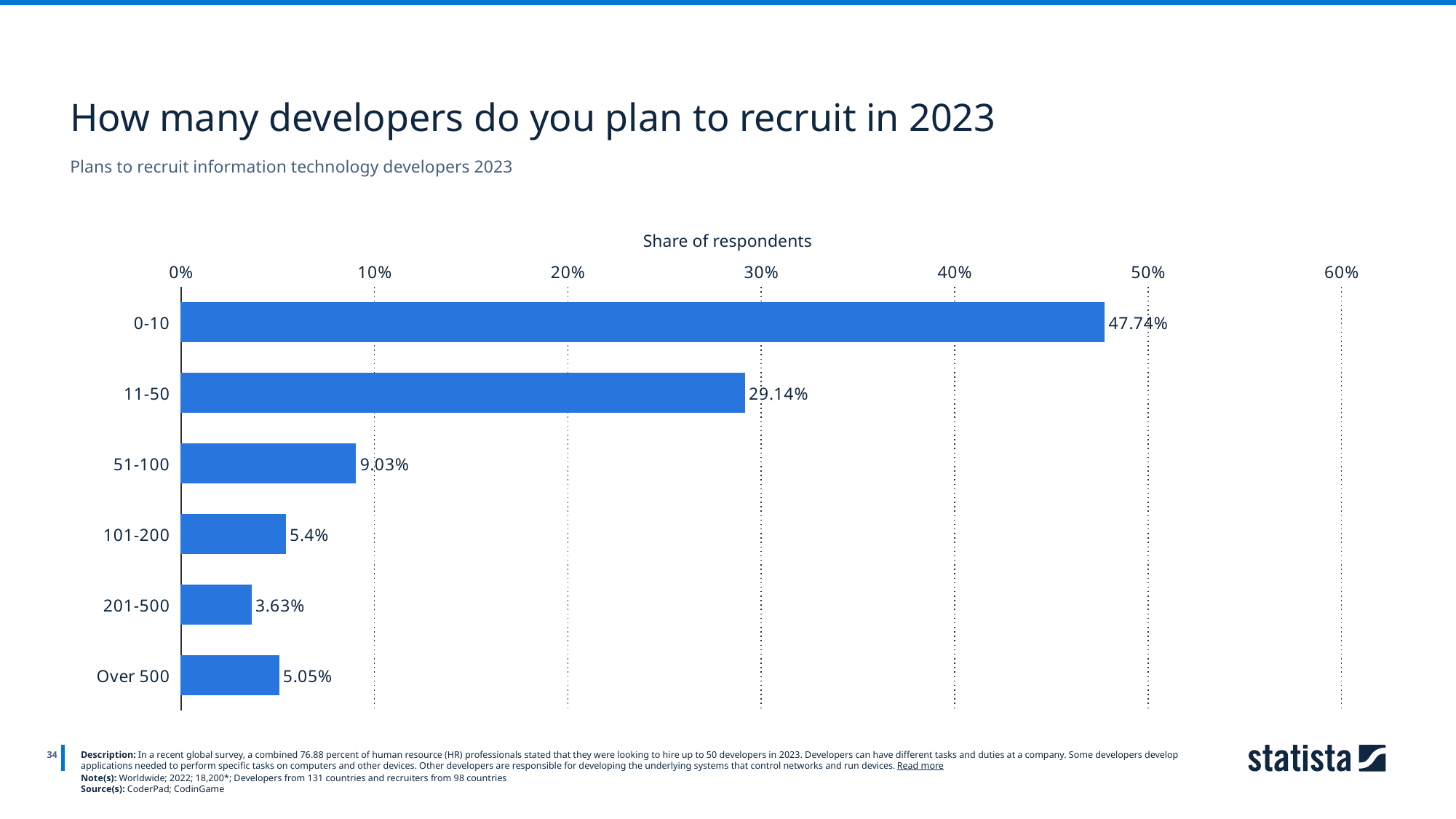
How many categories are shown in the chart? 6 Is the value for 51-100 greater or less than 10%? less What is the value for the 201-500 category? 3.63% What is the difference between the shares for 0-10 and 11-50? 18.6% Which is larger, the share for 101-200 or the share for Over 500? 101-200 Which category has the highest share of respondents? 0-10 What is the value for the Over 500 category? 5.05% What share of respondents plan to recruit 0-10 developers? 47.74% What share of respondents plan to recruit 11-50 developers? 29.14% What kind of chart is shown on the slide? bar chart Which category has the lowest share of respondents? 201-500 What is the label of the horizontal axis? Share of respondents